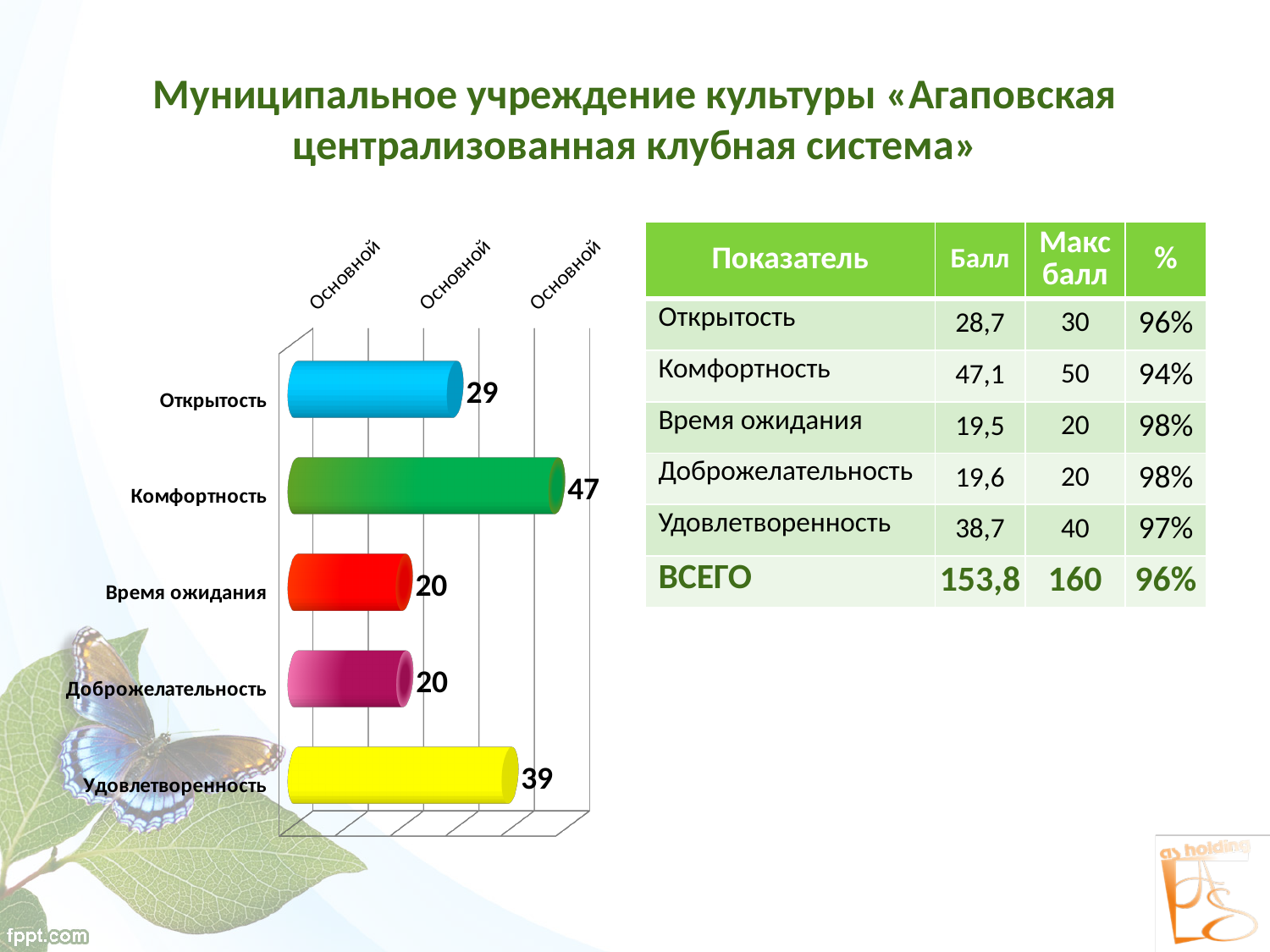
Which two categories in the bar chart share the same value of 20? Время ожидания and Доброжелательность What is the difference between the values for Комфортность and Удовлетворенность in the bar chart? 8 What is the value shown for Удовлетворенность in the bar chart? 39 What type of chart is shown on the slide? Bar chart Which category has the highest value in the bar chart? Комфортность What is the value shown for Комфортность in the bar chart? 47 How many categories does the bar chart show? 5 What is the value shown for Открытость in the bar chart? 29 Which is larger in the bar chart, the value for Открытость or the value for Удовлетворенность? Удовлетворенность What is the value shown for Доброжелательность in the bar chart? 20 What colour is the bar for Комфортность in the bar chart? Green What is the difference between the values for Открытость and Время ожидания in the bar chart? 9